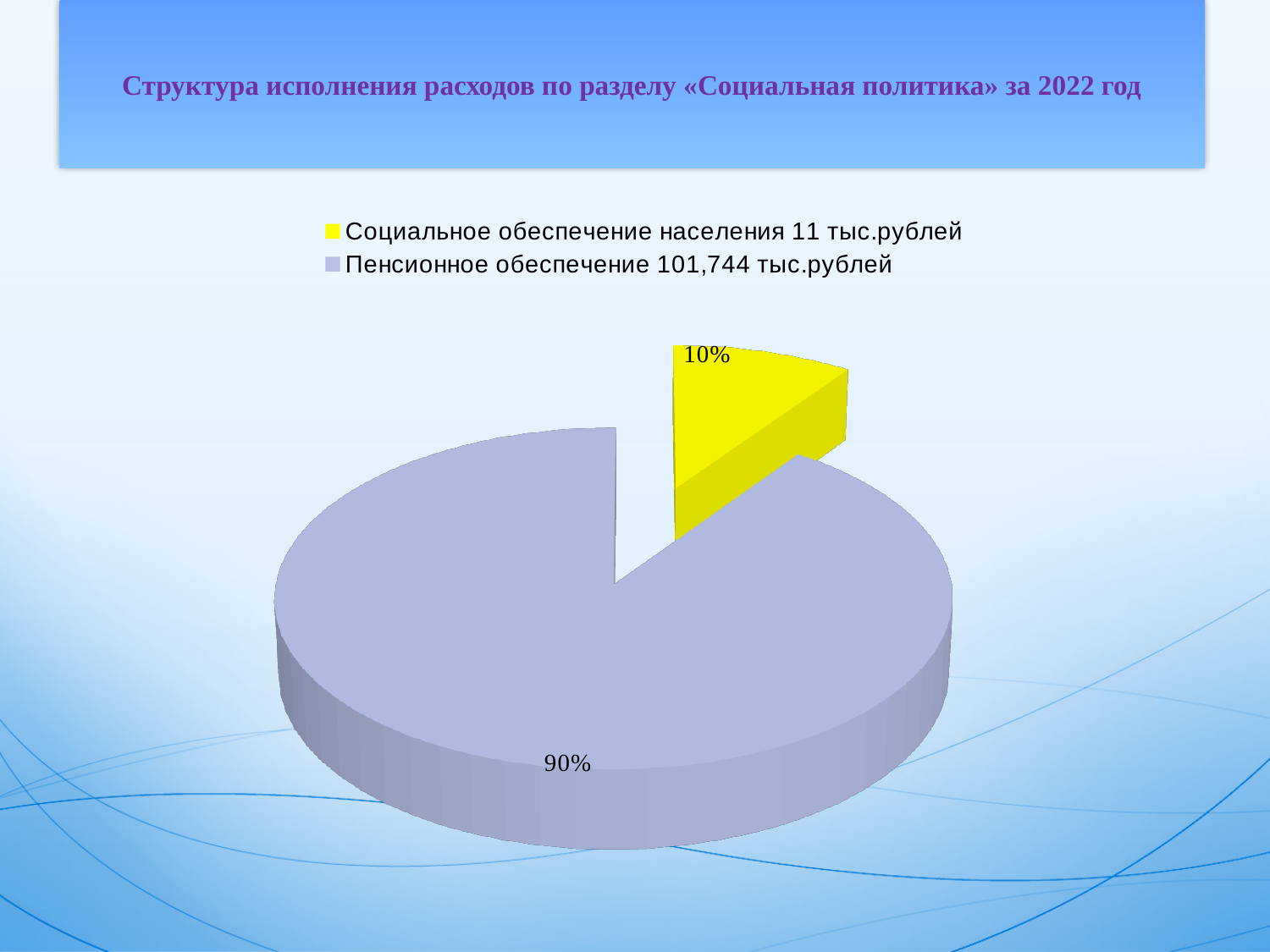
Which is larger: the share for «Пенсионное обеспечение» or the share for «Социальное обеспечение населения»? Пенсионное обеспечение What kind of chart is shown on the slide? Pie chart What share of the pie does «Пенсионное обеспечение» take? 90% What colour is the slice for «Социальное обеспечение населения»? Yellow What amount in тыс.рублей does the legend give for «Пенсионное обеспечение»? 101,744 тыс.рублей By how many percentage points does the «Пенсионное обеспечение» share exceed the «Социальное обеспечение населения» share? 80 percentage points What share of the pie does «Социальное обеспечение населения» take? 10% Which slice of the pie is the smallest? Социальное обеспечение населения Which slice of the pie is the largest? Пенсионное обеспечение What amount in тыс.рублей does the legend give for «Социальное обеспечение населения»? 11 тыс.рублей How many slices does the pie chart have? 2 How many entries does the legend list? 2